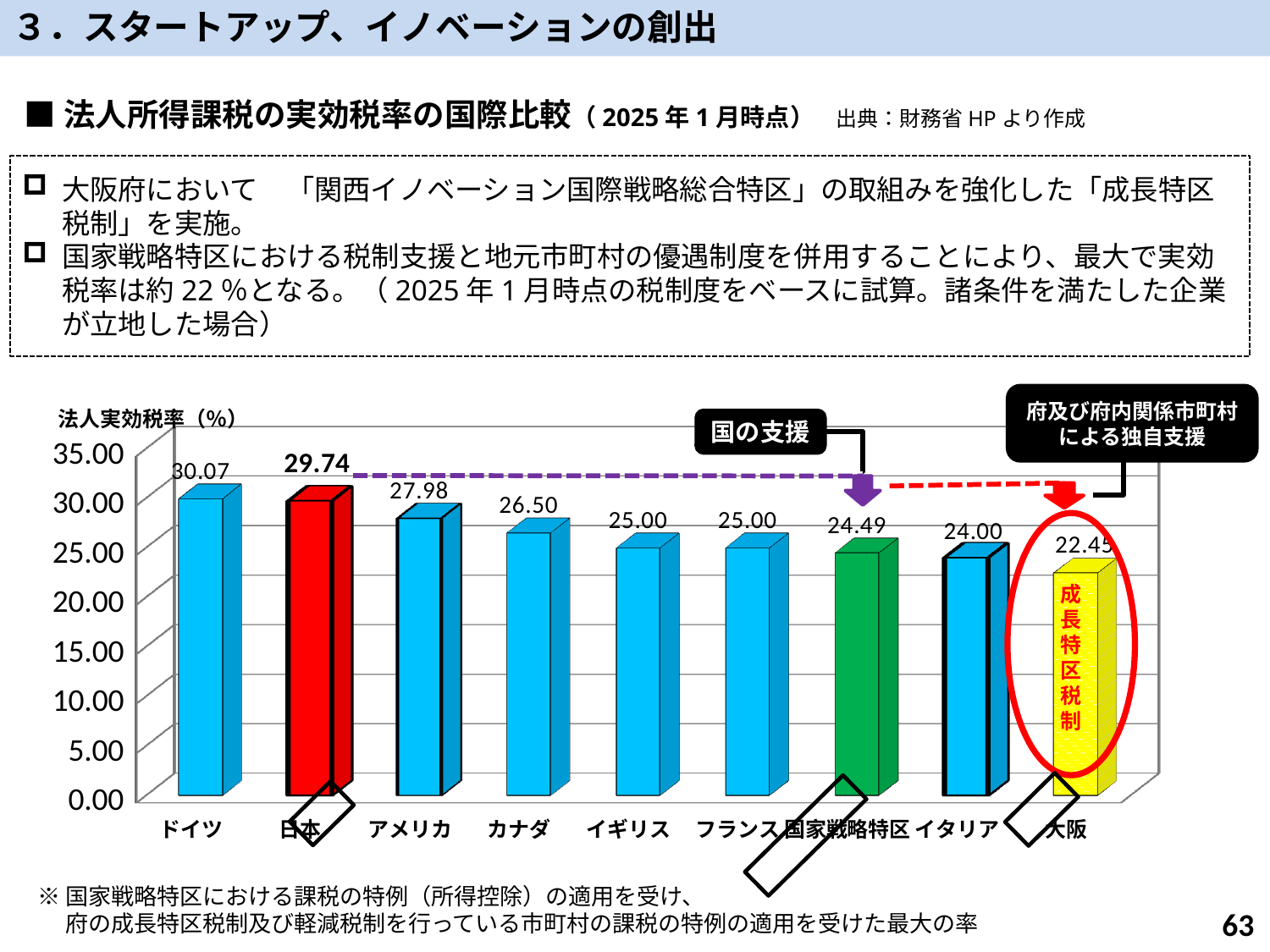
What kind of chart is shown on the slide? bar chart What is the value for 日本 in the chart? 29.74 How many categories are shown on the x axis of the chart? 9 What is the difference between the values for 日本 and アメリカ? 1.76 Which is larger, the value for カナダ or the value for イタリア? カナダ Which category has the lowest value in the chart? 大阪 What is the value for ドイツ in the 法人実効税率 chart? 30.07 What is the difference between the values for ドイツ and 大阪? 7.62 What is the value for 国家戦略特区 in the chart? 24.49 What is the label of the vertical axis of the chart? 法人実効税率（%） Which category has the highest value in the chart? ドイツ What is the value for 大阪 in the chart? 22.45